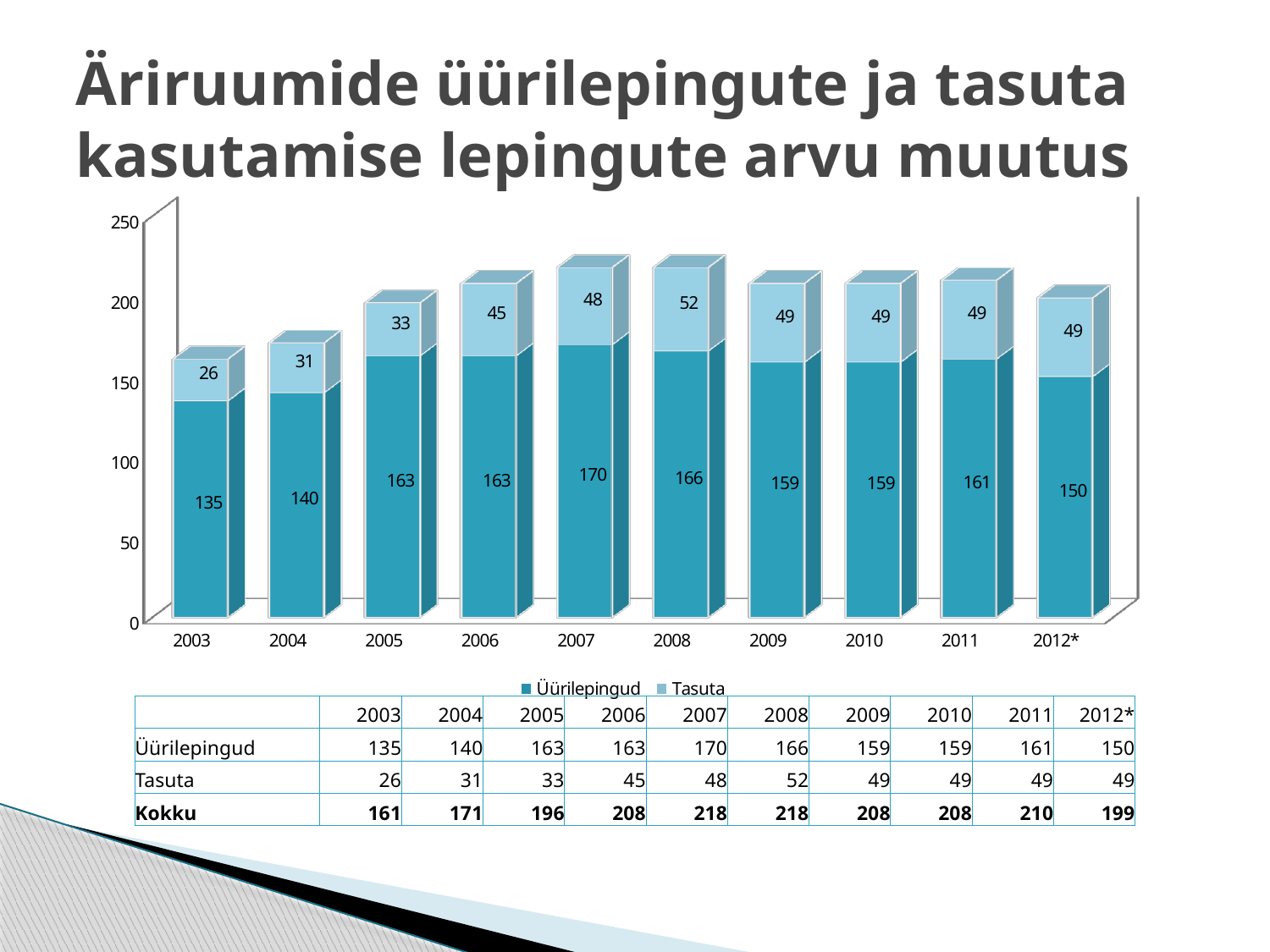
Which year has the lowest Tasuta value? 2003 What is the Tasuta value for 2004? 31 What is the difference between the Üürilepingud values for 2005 and 2012*? 13 What is the total of the stacked bar for 2012*? 199 How many series does the legend list? 2 What is the total of the stacked bar for 2006? 208 How many years are shown on the x axis? 10 Which year has the highest Üürilepingud value? 2007 Which is larger, the Tasuta value for 2008 or for 2011? 2008 Which series is shown in the lighter blue colour? Tasuta What kind of chart is shown on the slide? Stacked bar chart What is the Üürilepingud value for 2007? 170